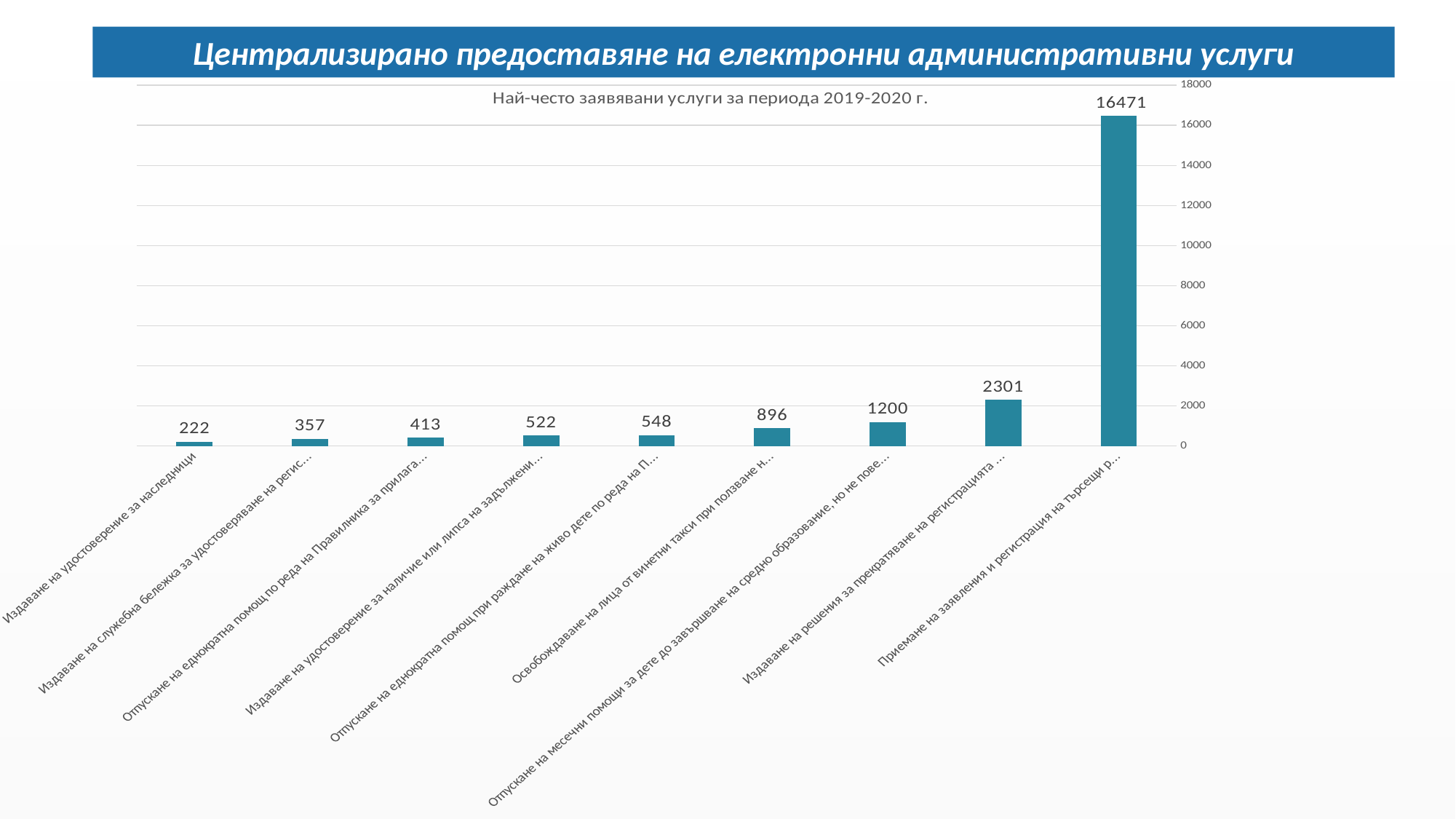
What is the value of the tallest bar, for the category beginning "Приемане на заявления и регистрация на търсещи р..."? 16471 What kind of chart is shown on the slide? Bar chart What is the value for "Издаване на удостоверение за наследници"? 222 How many categories (bars) are shown in the chart? 9 Do the values rise or fall from left to right along the x axis? Rise What is the value for the category beginning "Освобождаване на лица от винетни такси..."? 896 What is the title of the chart? Най-често заявявани услуги за периода 2019-2020 г. Which category has the lowest value? Издаване на удостоверение за наследници What is the value for the category beginning "Издаване на решения за прекратяване на регистрацията..."? 2301 Is the value for the category beginning "Издаване на решения за прекратяване..." greater or less than 2000? greater What is the difference between the value for the category beginning "Издаване на решения за прекратяване..." (2301) and the category beginning "Отпускане на месечни помощи за дете..." (1200)? 1101 Which is larger: the value for the category beginning "Отпускане на еднократна помощ при раждане..." or the category beginning "Издаване на удостоверение за наличие или липса..."? Отпускане на еднократна помощ при раждане... (548)